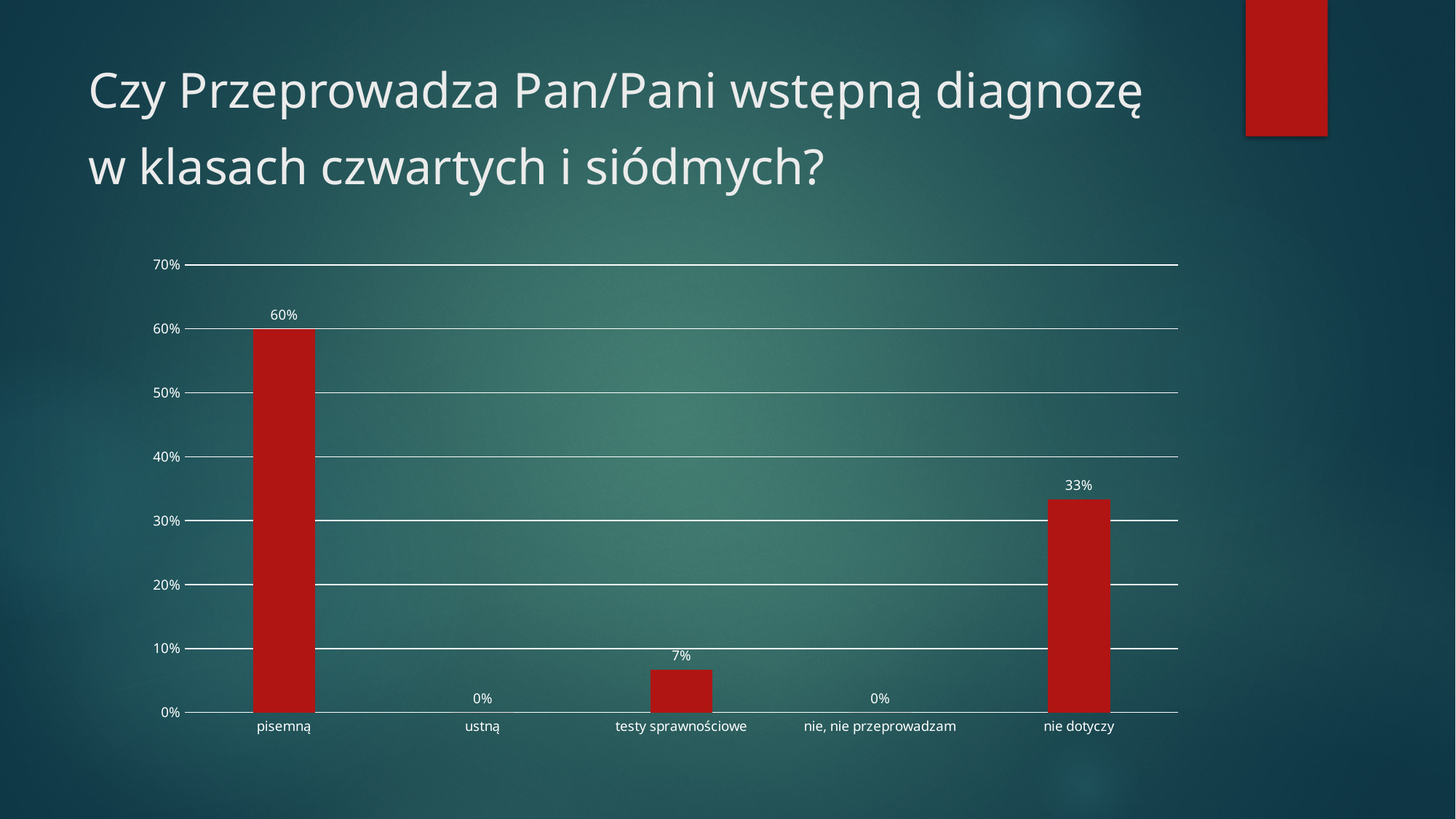
Which category has the highest value? pisemną What colour are the bars in the chart? red What kind of chart is shown on the slide? bar chart Is the value for "nie dotyczy" greater or less than 40%? less What is the value for "ustną"? 0% How many categories are shown on the x axis? 5 How many categories have a value of 0%? 2 What is the value for "nie dotyczy"? 33% Which is larger, the value for "testy sprawnościowe" or the value for "nie dotyczy"? nie dotyczy What is the value for "testy sprawnościowe"? 7% What is the value for "pisemną"? 60% What is the difference between the values for "pisemną" and "nie dotyczy"? 27%